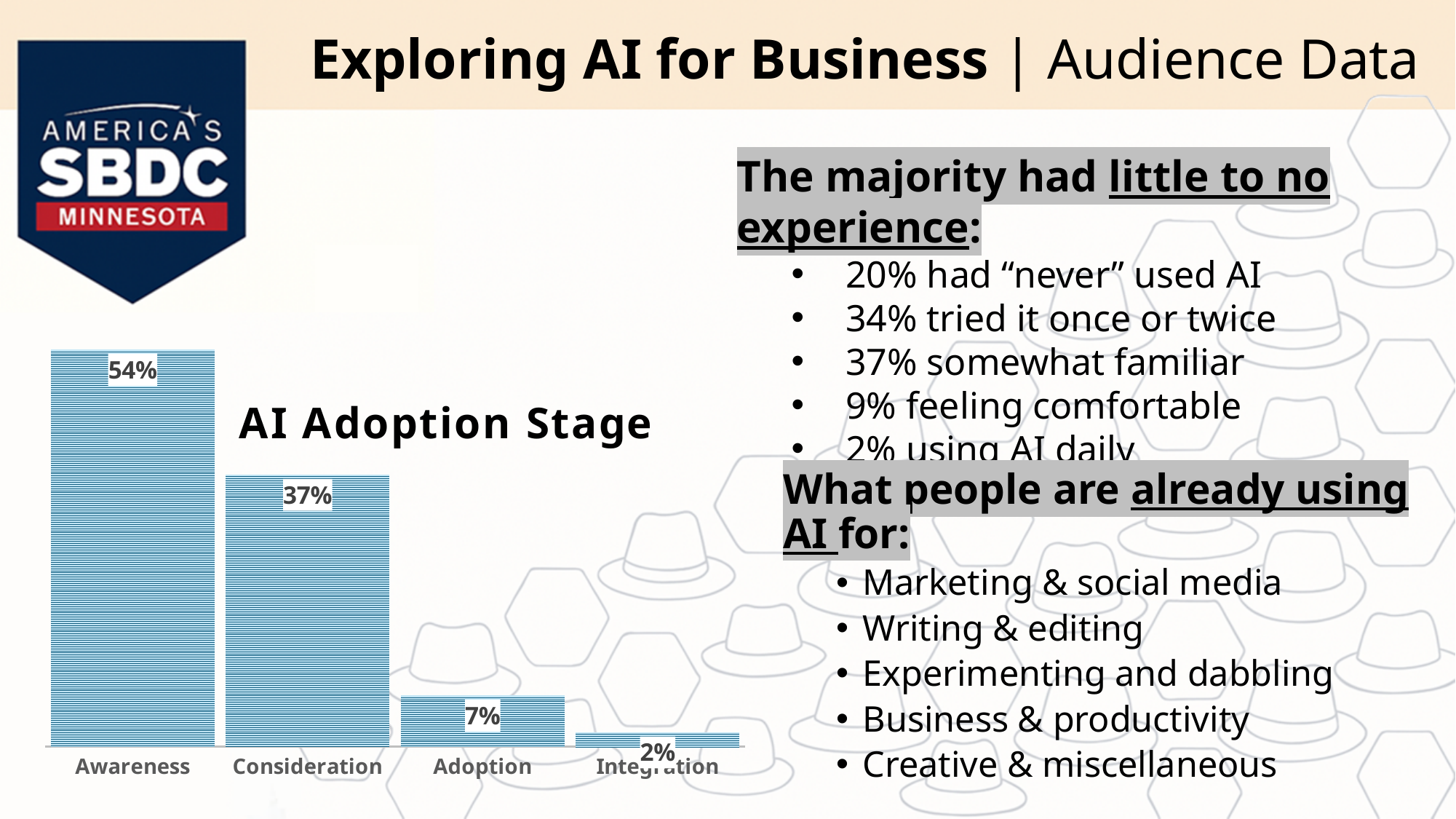
What kind of chart is the AI Adoption Stage chart? Bar chart What is the difference between the Adoption and Integration values? 5% What is the value for Adoption in the AI Adoption Stage chart? 7% What is the difference between the Awareness and Consideration values? 17% Do the values rise or fall from Awareness to Integration along the x axis? Fall Which adoption stage has the lowest value in the chart? Integration What is the value for Integration in the AI Adoption Stage chart? 2% Which is larger, the value for Consideration or the value for Adoption? Consideration What is the value for Consideration in the AI Adoption Stage chart? 37% Which adoption stage has the highest value in the chart? Awareness What is the value for Awareness in the AI Adoption Stage chart? 54% How many adoption stages are shown in the chart? 4